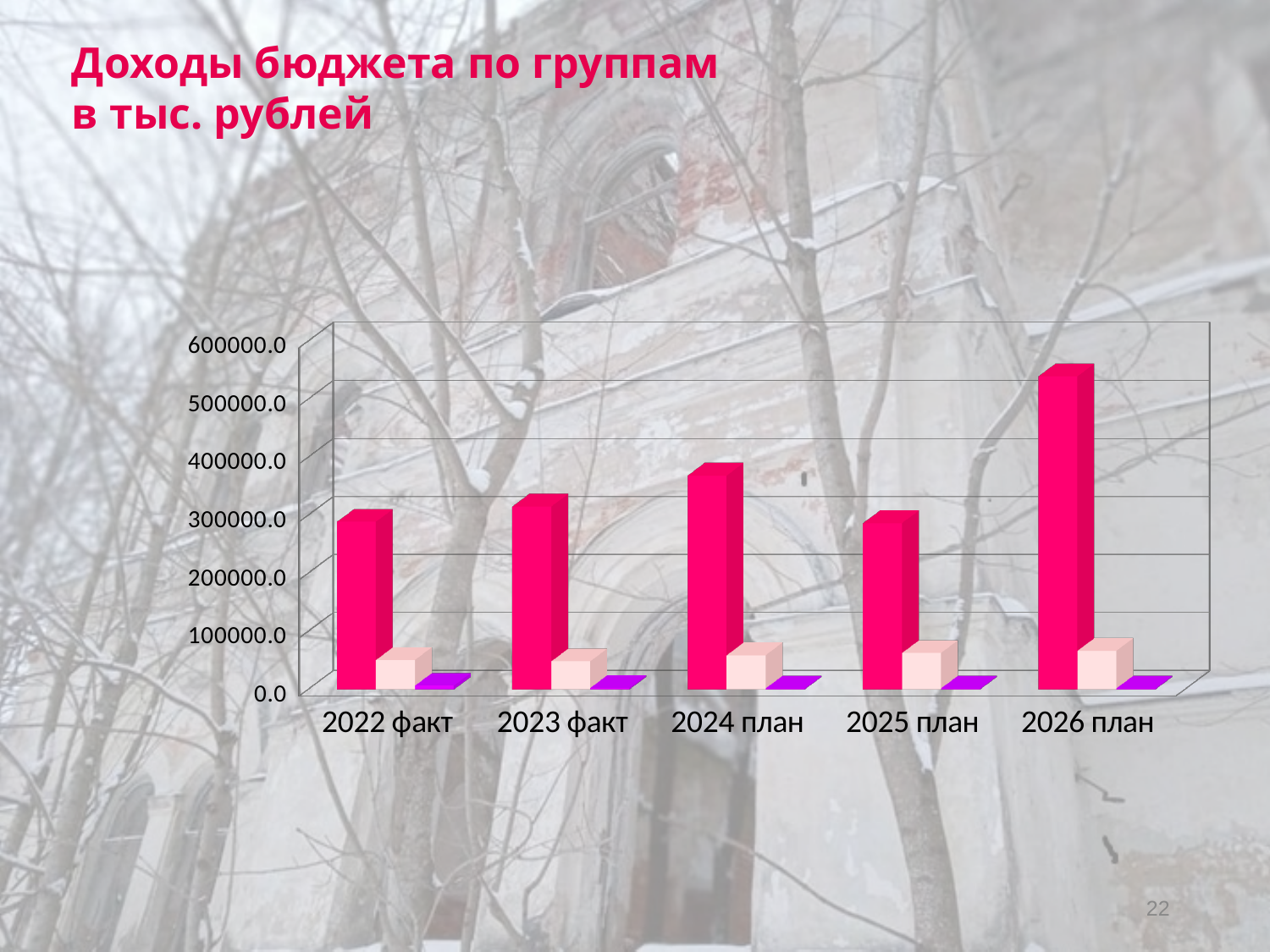
Which magenta bar is taller, 2026 план or 2025 план? 2026 план How many categories are shown on the x axis? 5 Is the magenta bar for 2024 план greater or less than 400000.0? less Is the magenta bar for 2024 план greater or less than 300000.0? greater Which category has the tallest magenta bar? 2026 план How many bars are plotted for each category? 3 Is the pale pink bar for 2026 план greater or less than 100000.0? less What is the title of the chart? Доходы бюджета по группам в тыс. рублей Which magenta bar is taller, 2024 план or 2023 факт? 2024 план What kind of chart is shown on the slide? bar chart